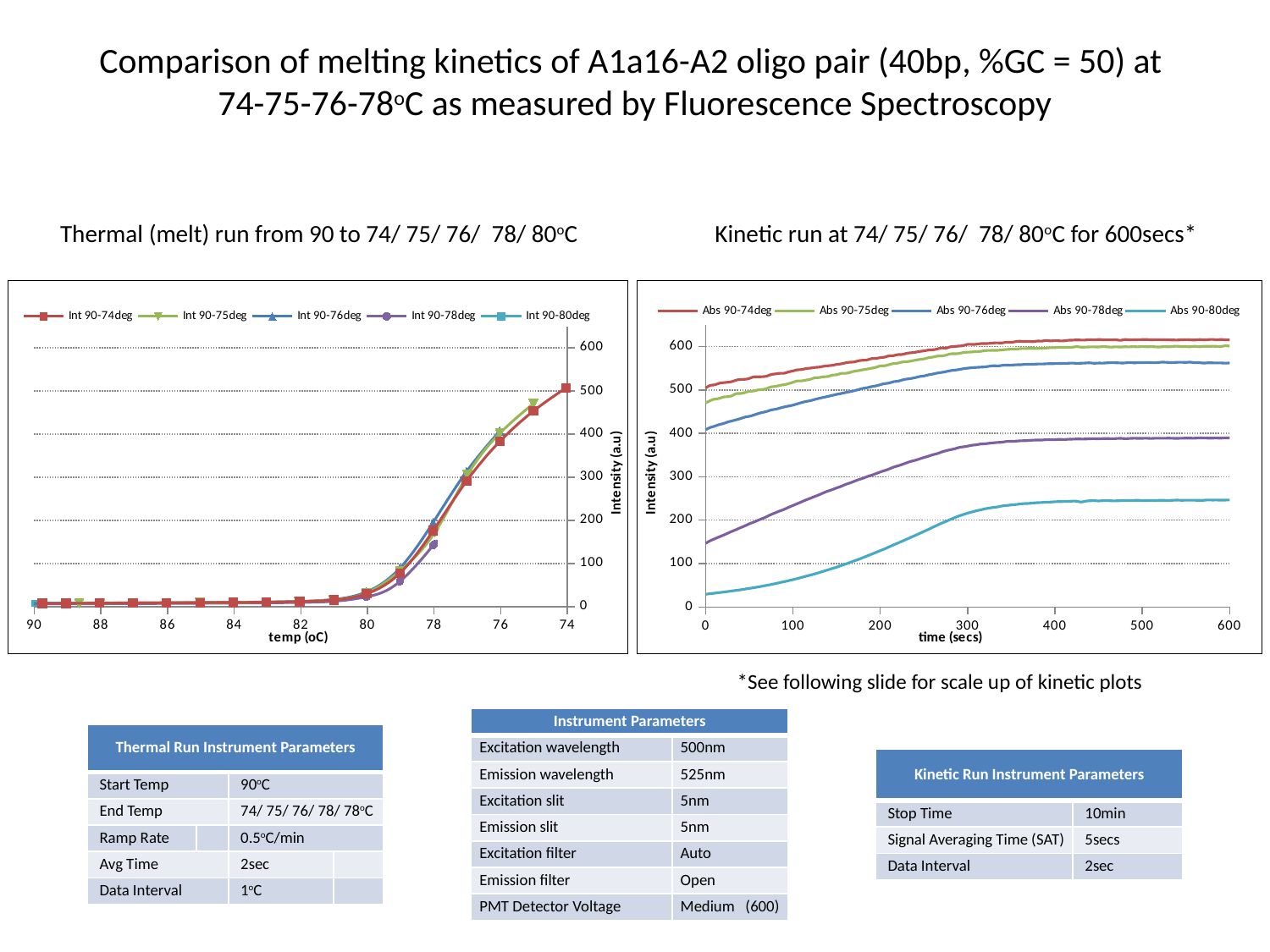
What kind of chart is the left chart, 'Thermal (melt) run from 90 to 74/ 75/ 76/ 78/ 80°C'? line chart In the right chart, 'Kinetic run', is the intensity of Abs 90-80deg at 0 secs greater or less than 100? less In the right chart, 'Kinetic run', which series has the lowest intensity at 600 secs? Abs 90-80deg How many series does the legend of the left chart, 'Thermal (melt) run', list? 5 In the left chart, 'Thermal (melt) run', is the intensity of Int 90-74deg at 90°C greater or less than 100? less In the right chart, 'Kinetic run', do the intensity values rise or fall as time increases? rise How many series does the legend of the right chart, 'Kinetic run at 74/ 75/ 76/ 78/ 80°C for 600secs', list? 5 In the left chart, 'Thermal (melt) run', is the intensity of Int 90-74deg at 74°C greater or less than 400? greater In the right chart, 'Kinetic run', which is larger at 600 secs: Abs 90-76deg or Abs 90-78deg? Abs 90-76deg What is the x-axis title of the right chart, 'Kinetic run'? time (secs)